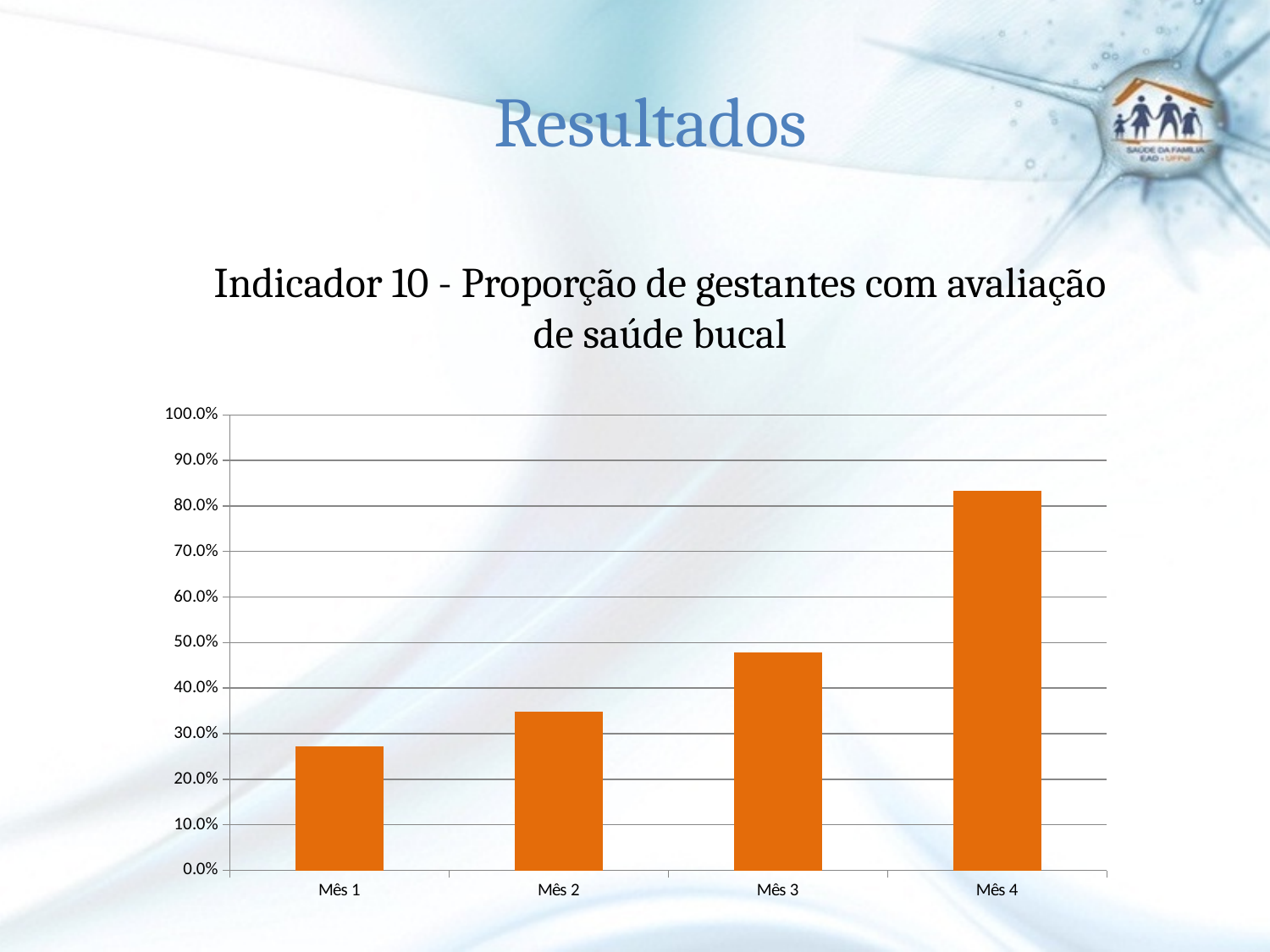
Do the values rise or fall from Mês 1 to Mês 4? rise What kind of chart is shown on the slide? bar chart Which month has the highest value? Mês 4 Is the value for Mês 4 greater or less than 80.0%? greater What colour are the bars in the chart? orange Which is larger, the value for Mês 2 or the value for Mês 3? Mês 3 Which month has the lowest value? Mês 1 Is the value for Mês 2 greater or less than 30.0%? greater Is the value for Mês 3 greater or less than 50.0%? less How many categories are plotted on the x axis? 4 What is the title of the chart? Indicador 10 - Proporção de gestantes com avaliação de saúde bucal